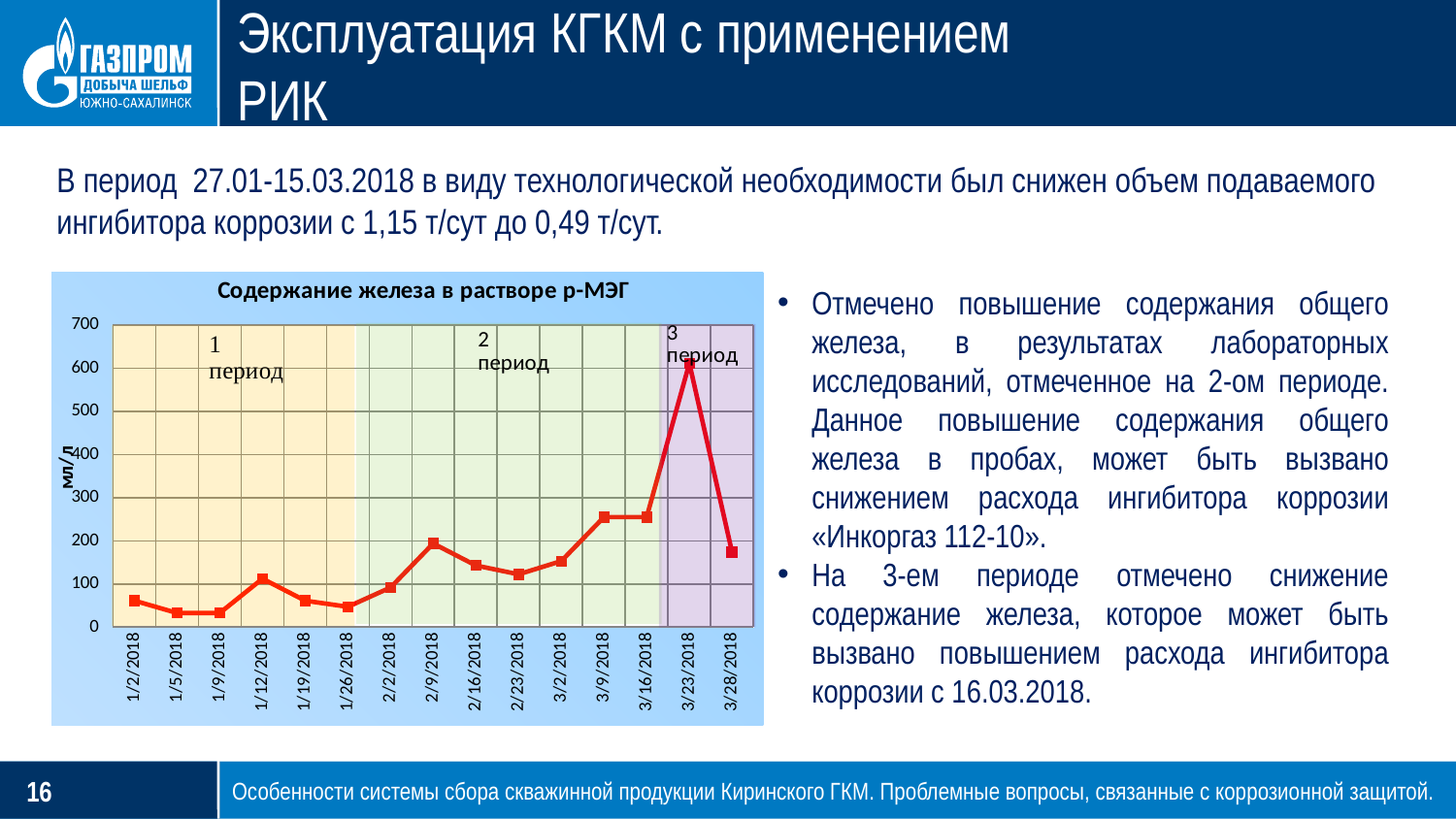
Is the value for 2/9/2018 greater or less than 100? greater Which has the larger value, 2/9/2018 or 1/5/2018? 2/9/2018 On which date does the chart reach its highest value? 3/23/2018 Does the value rise or fall between 3/23/2018 and 3/28/2018? fall Is the value for 1/2/2018 greater or less than 100? less Which has the larger value, 3/23/2018 or 3/28/2018? 3/23/2018 What type of chart is shown on the slide? line chart What is the label on the vertical axis of the chart? мл/л What is the title of the chart? Содержание железа в растворе р-МЭГ How many data points are plotted on the chart? 15 Is the value for 3/9/2018 greater or less than 200? greater